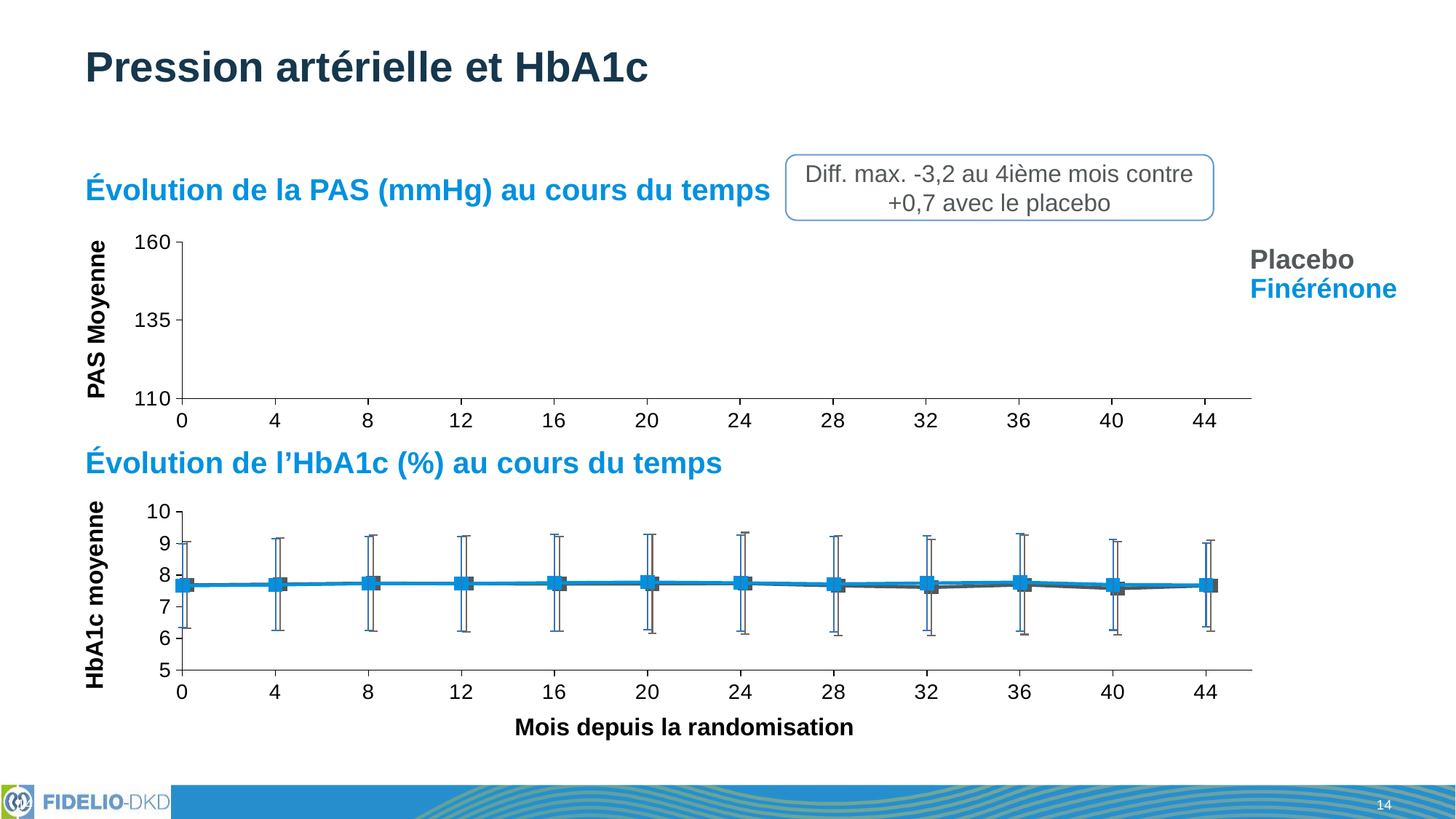
In the 'Évolution de l'HbA1c (%) au cours du temps' chart, is the Placebo value at 36 months greater or less than 6? greater In the 'Évolution de l'HbA1c (%) au cours du temps' chart, is the Finérénone value at 20 months greater or less than 8? less In the 'Évolution de l'HbA1c (%) au cours du temps' chart, do the HbA1c values rise, fall or stay roughly flat from 0 to 44 months? stay roughly flat What is the x-axis label of the 'Évolution de l'HbA1c (%) au cours du temps' chart? Mois depuis la randomisation In the 'Évolution de l'HbA1c (%) au cours du temps' chart, is the Placebo value at 44 months greater or less than 7? greater In the 'Évolution de l'HbA1c (%) au cours du temps' chart, how many time points are plotted along the x axis? 12 What kind of chart is the 'Évolution de l'HbA1c (%) au cours du temps' chart? line chart In the 'Évolution de l'HbA1c (%) au cours du temps' chart, how many series does the legend list? 2 Which series is shown in blue in the legend on the slide? Finérénone